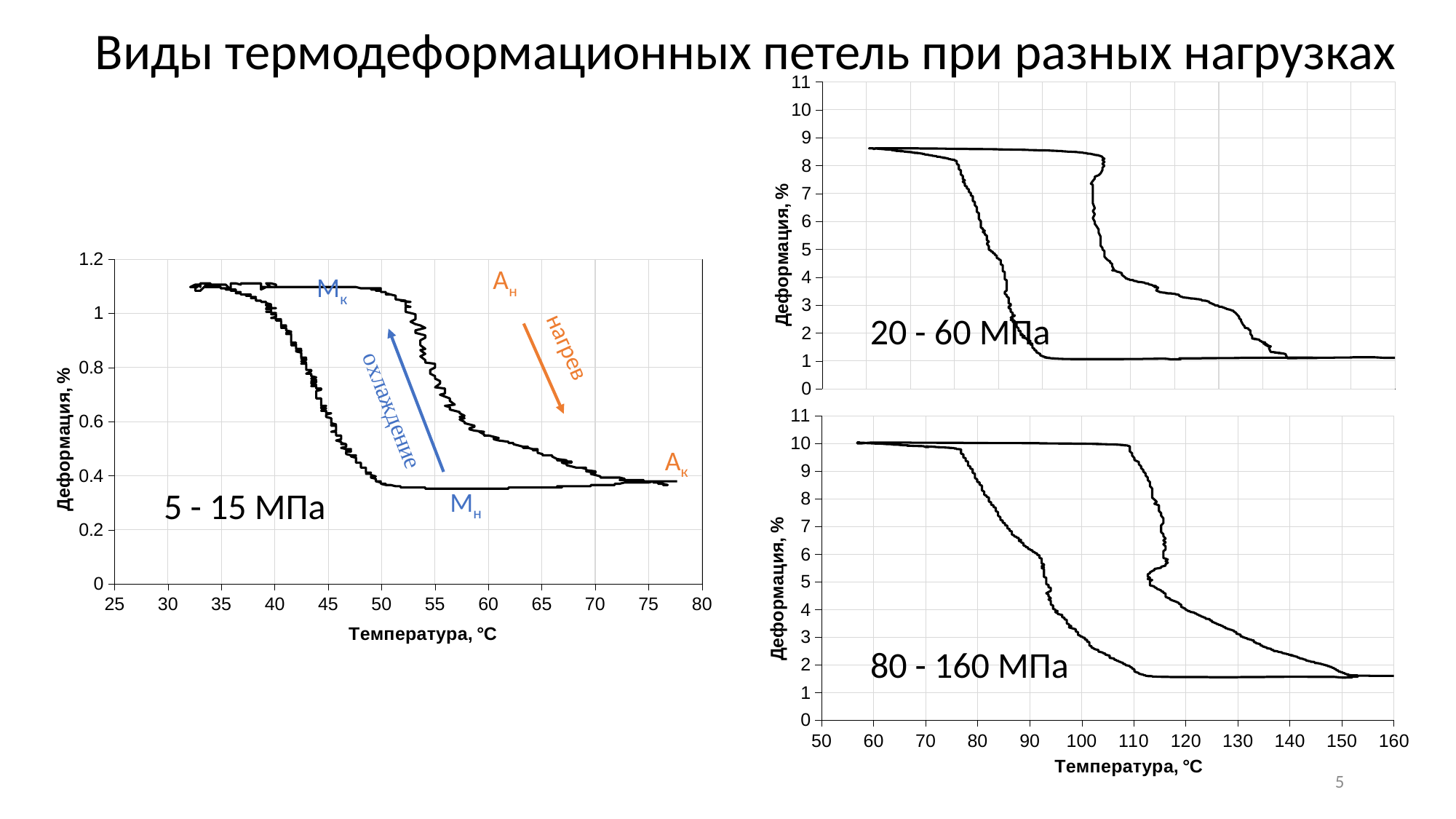
Which chart reaches the higher maximum deformation: "20 - 60 МПа" or "80 - 160 МПа"? 80 - 160 МПа In the "5 - 15 МПа" chart, is the highest deformation value greater or less than 1? greater What is the label of the x axis on the "80 - 160 МПа" chart? Температура, °C In the "5 - 15 МПа" chart, is the lowest deformation value greater or less than 0.6? less In the "5 - 15 МПа" chart, along the heating branch from 55 °C to 70 °C, does the deformation rise or fall as temperature increases? fall In the "20 - 60 МПа" chart, is the deformation at 60 °C greater or less than the deformation at 150 °C? greater What kind of chart is the one labelled "5 - 15 МПа"? line chart In the "80 - 160 МПа" chart, is the highest deformation value greater or less than 9? greater How many charts are shown on the slide? 3 In the "5 - 15 МПа" chart, what does the orange arrow label say? нагрев